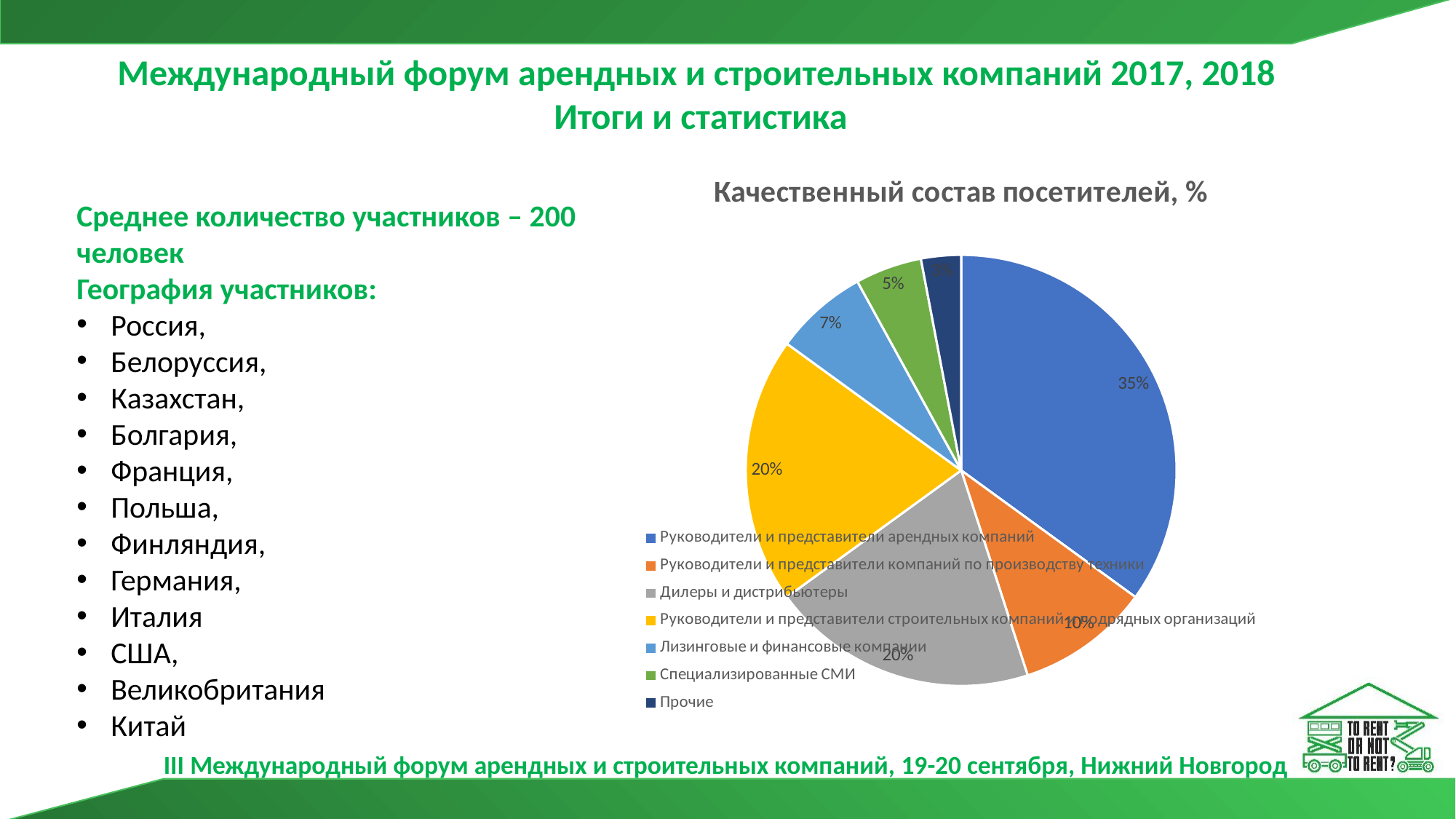
What share of visitors are Специализированные СМИ? 5% What kind of chart is shown on the slide? pie chart How many categories does the legend list? 7 What share of visitors are Лизинговые и финансовые компании? 7% What share of visitors are Дилеры и дистрибьюторы? 20% What is the title of the chart? Качественный состав посетителей, % What share of visitors are Руководители и представители арендных компаний? 35% Which is larger: the share of Специализированные СМИ or the share of Лизинговые и финансовые компании? Лизинговые и финансовые компании Which category has the smallest share of visitors? Прочие Which category has the largest share of visitors? Руководители и представители арендных компаний What share of visitors are Руководители и представители компаний по производству техники? 10% How many percentage points larger is the share of Руководители и представители арендных компаний than the share of Лизинговые и финансовые компании? 28